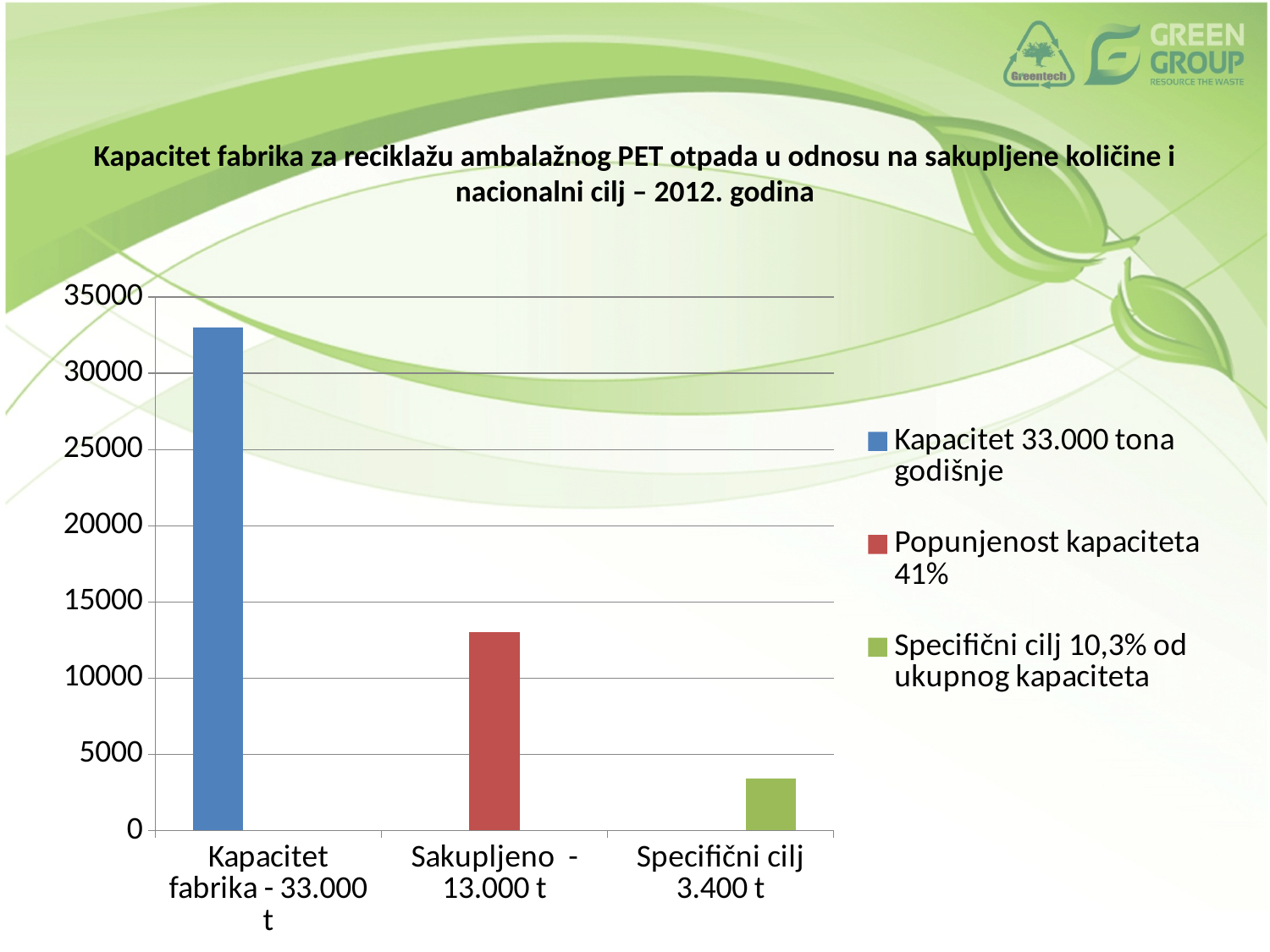
What type of chart is shown on the slide? bar chart Which is larger, the bar for 'Sakupljeno' or the bar for 'Specifični cilj'? Sakupljeno Which category has the lowest bar? Specifični cilj Is the bar for 'Kapacitet fabrika' greater or less than 30000? greater What value is given for 'Kapacitet fabrika' in the category label? 33.000 t Which category has the highest bar? Kapacitet fabrika How many bars are plotted in the chart? 3 What value is given for 'Specifični cilj' in the category label? 3.400 t Is the bar for 'Sakupljeno' greater or less than 15000? less How many entries does the chart legend list? 3 What percentage does the legend give for 'Popunjenost kapaciteta'? 41% What value is given for 'Sakupljeno' in the category label? 13.000 t